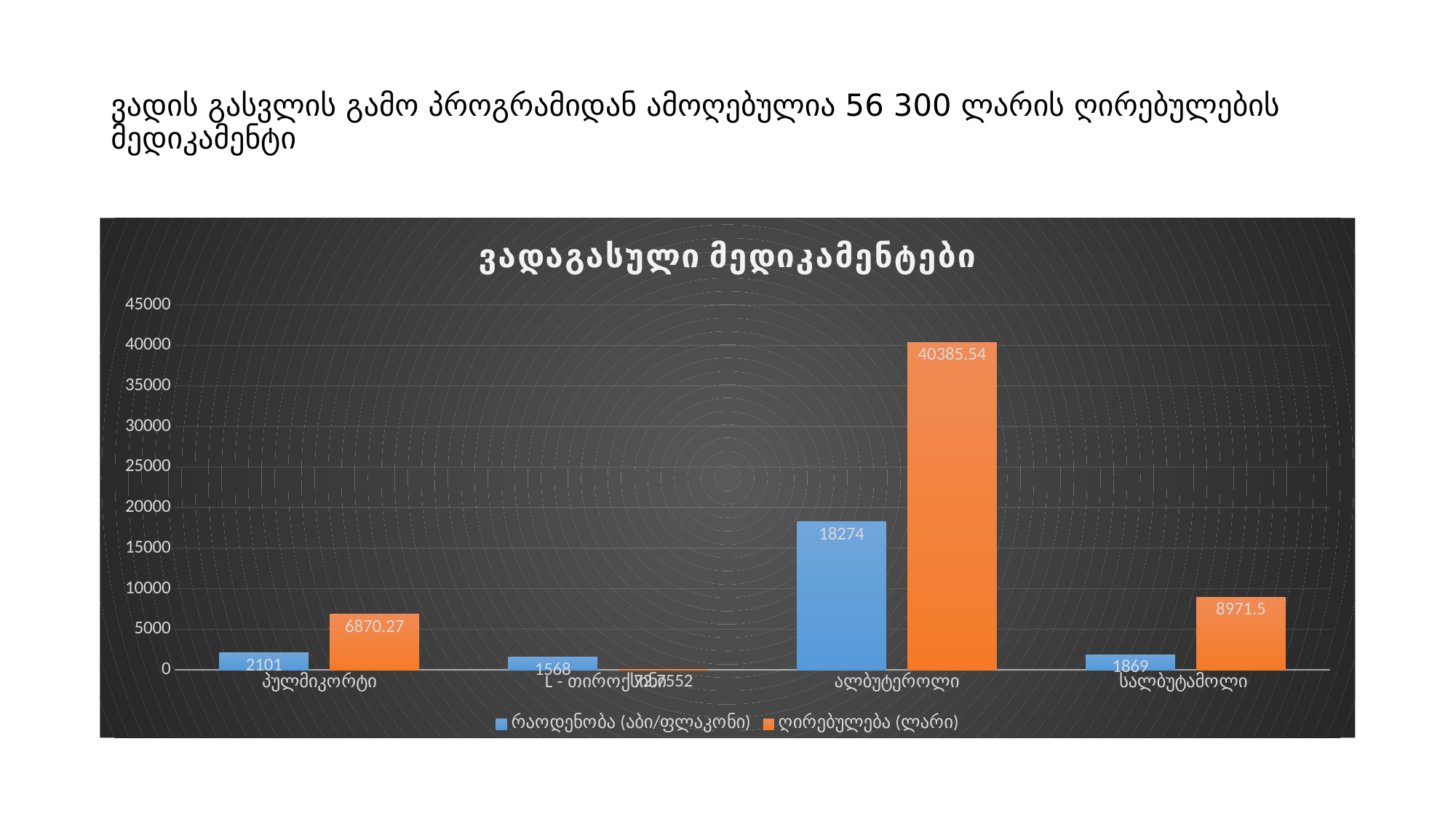
What is the difference between the ღირებულება (ლარი) values for სალბუტამოლი and პულმიკორტი? 2101.23 How many categories are shown on the x axis of the chart? 4 Is the ღირებულება (ლარი) value for ალბუტეროლი greater or less than 35000? greater What type of chart is shown on the slide? bar chart How many series does the chart legend list? 2 What is the რაოდენობა (აბი/ფლაკონი) value for პულმიკორტი? 2101 What is the ღირებულება (ლარი) value for სალბუტამოლი? 8971.5 What is the ღირებულება (ლარი) value for ალბუტეროლი? 40385.54 What is the რაოდენობა (აბი/ფლაკონი) value for L - თიროქსინი? 1568 What is the title of the chart? ვადაგასული მედიკამენტები Which category has the lowest რაოდენობა (აბი/ფლაკონი) value? L - თიროქსინი Which category has the highest ღირებულება (ლარი) value? ალბუტეროლი